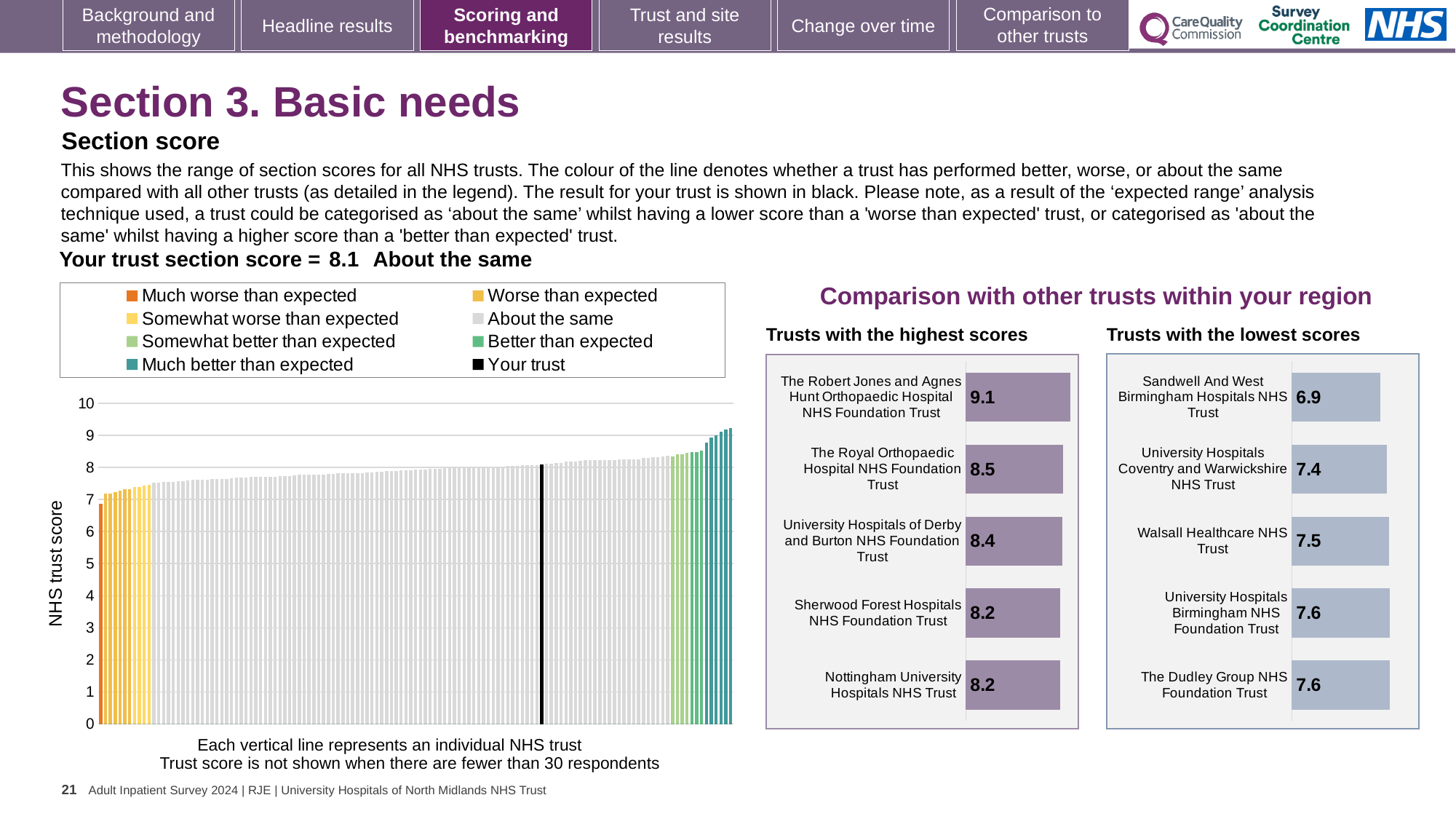
How many trusts are shown in the 'Trusts with the highest scores' chart? 5 What kind of chart is the main 'NHS trust score' chart on the left of the slide? bar chart In the 'Trusts with the highest scores' chart, which trust has the highest score? The Robert Jones and Agnes Hunt Orthopaedic Hospital NHS Foundation Trust In the 'Trusts with the highest scores' chart, what is the score for The Robert Jones and Agnes Hunt Orthopaedic Hospital NHS Foundation Trust? 9.1 How many entries does the legend of the main 'NHS trust score' chart list? 8 Which has the higher score: University Hospitals of Derby and Burton NHS Foundation Trust in the highest scores chart, or University Hospitals Coventry and Warwickshire NHS Trust in the lowest scores chart? University Hospitals of Derby and Burton NHS Foundation Trust In the 'Trusts with the highest scores' chart, what is the score for Sherwood Forest Hospitals NHS Foundation Trust? 8.2 In the 'Trusts with the lowest scores' chart, which trust has the lowest score? Sandwell And West Birmingham Hospitals NHS Trust In the 'Trusts with the lowest scores' chart, what is the score for Sandwell And West Birmingham Hospitals NHS Trust? 6.9 In the main 'NHS trust score' chart, what is the section score for your trust, as stated on the slide? 8.1 In the 'Trusts with the highest scores' chart, what is the difference between the scores of The Robert Jones and Agnes Hunt Orthopaedic Hospital NHS Foundation Trust and The Royal Orthopaedic Hospital NHS Foundation Trust? 0.6 In the 'Trusts with the lowest scores' chart, what is the difference between the scores of The Dudley Group NHS Foundation Trust and Sandwell And West Birmingham Hospitals NHS Trust? 0.7